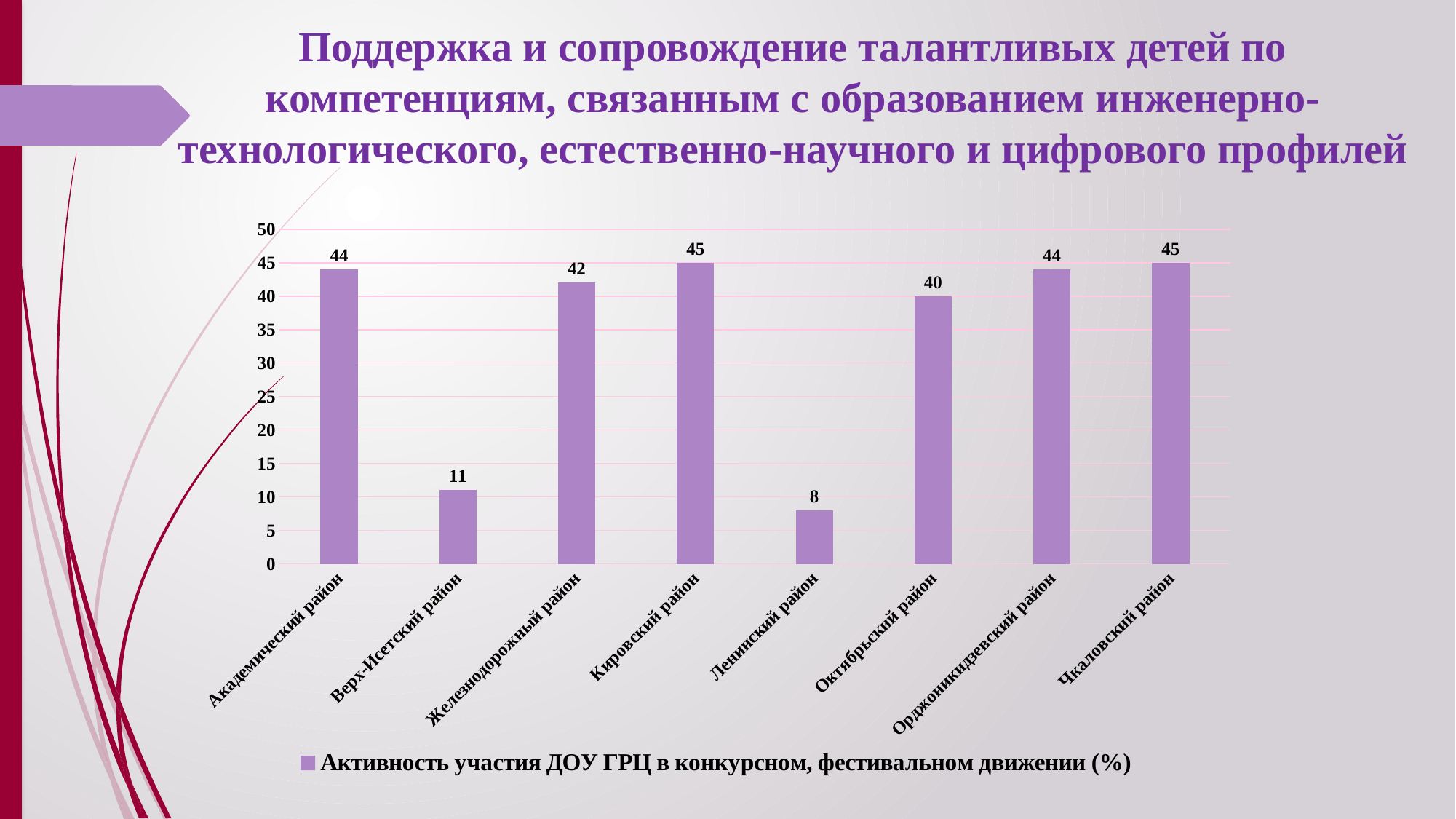
Which is larger, the value for Октябрьский район or the value for Орджоникидзевский район? Орджоникидзевский район Which district has the lowest value? Ленинский район What is the value for Октябрьский район? 40 What is the value for Железнодорожный район? 42 What is the difference between the values for Кировский район and Ленинский район? 37 How many series does the legend list? 1 Is the value for Верх-Исетский район greater or less than 15? less How many districts are shown on the chart? 8 What is the value for Верх-Исетский район? 11 What is the value for Ленинский район? 8 What is the difference between the values for Академический район and Верх-Исетский район? 33 What kind of chart is shown on the slide? bar chart